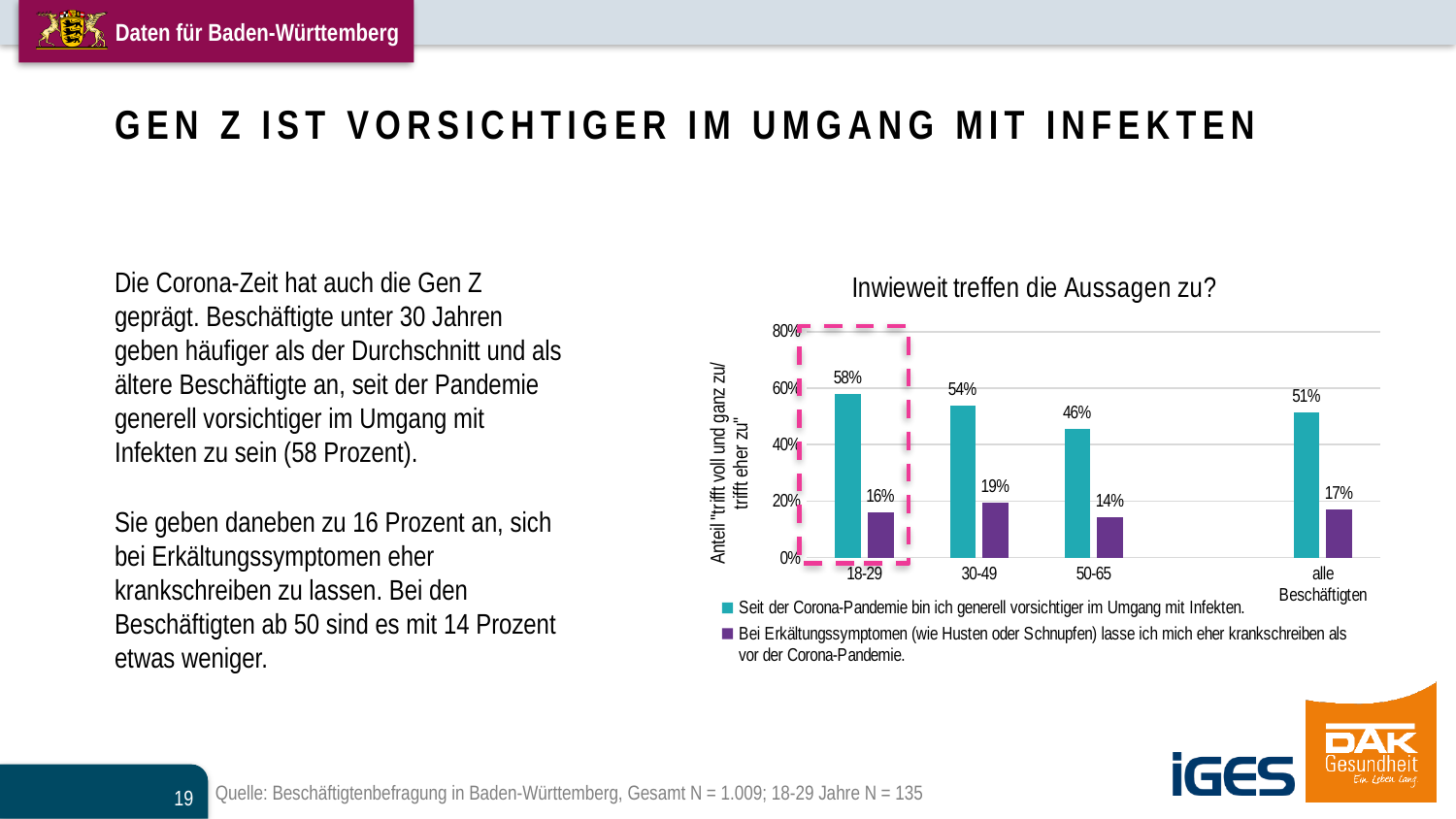
What kind of chart is shown on the slide? bar chart Is the value for the 50-65 group for the series "Seit der Corona-Pandemie bin ich generell vorsichtiger im Umgang mit Infekten." greater or less than 40%? greater What is the value for the 50-65 group for the series "Bei Erkältungssymptomen (wie Husten oder Schnupfen) lasse ich mich eher krankschreiben als vor der Corona-Pandemie."? 14% Which category has the lowest value for the series "Bei Erkältungssymptomen ... lasse ich mich eher krankschreiben als vor der Corona-Pandemie."? 50-65 Which age group has the highest value for the series "Seit der Corona-Pandemie bin ich generell vorsichtiger im Umgang mit Infekten."? 18-29 What is the value for "alle Beschäftigten" for the series "Seit der Corona-Pandemie bin ich generell vorsichtiger im Umgang mit Infekten."? 51% How many series does the chart's legend list? 2 How many categories are shown on the x axis of the chart? 4 Which is larger for the 30-49 group: the value for "Seit der Corona-Pandemie bin ich generell vorsichtiger im Umgang mit Infekten." or the value for "Bei Erkältungssymptomen ... lasse ich mich eher krankschreiben"? Seit der Corona-Pandemie bin ich generell vorsichtiger im Umgang mit Infekten. What is the value for the 18-29 group for the series "Seit der Corona-Pandemie bin ich generell vorsichtiger im Umgang mit Infekten."? 58% What is the title of the chart? Inwieweit treffen die Aussagen zu? What is the difference between the 18-29 group and the 50-65 group for the series "Seit der Corona-Pandemie bin ich generell vorsichtiger im Umgang mit Infekten."? 12%